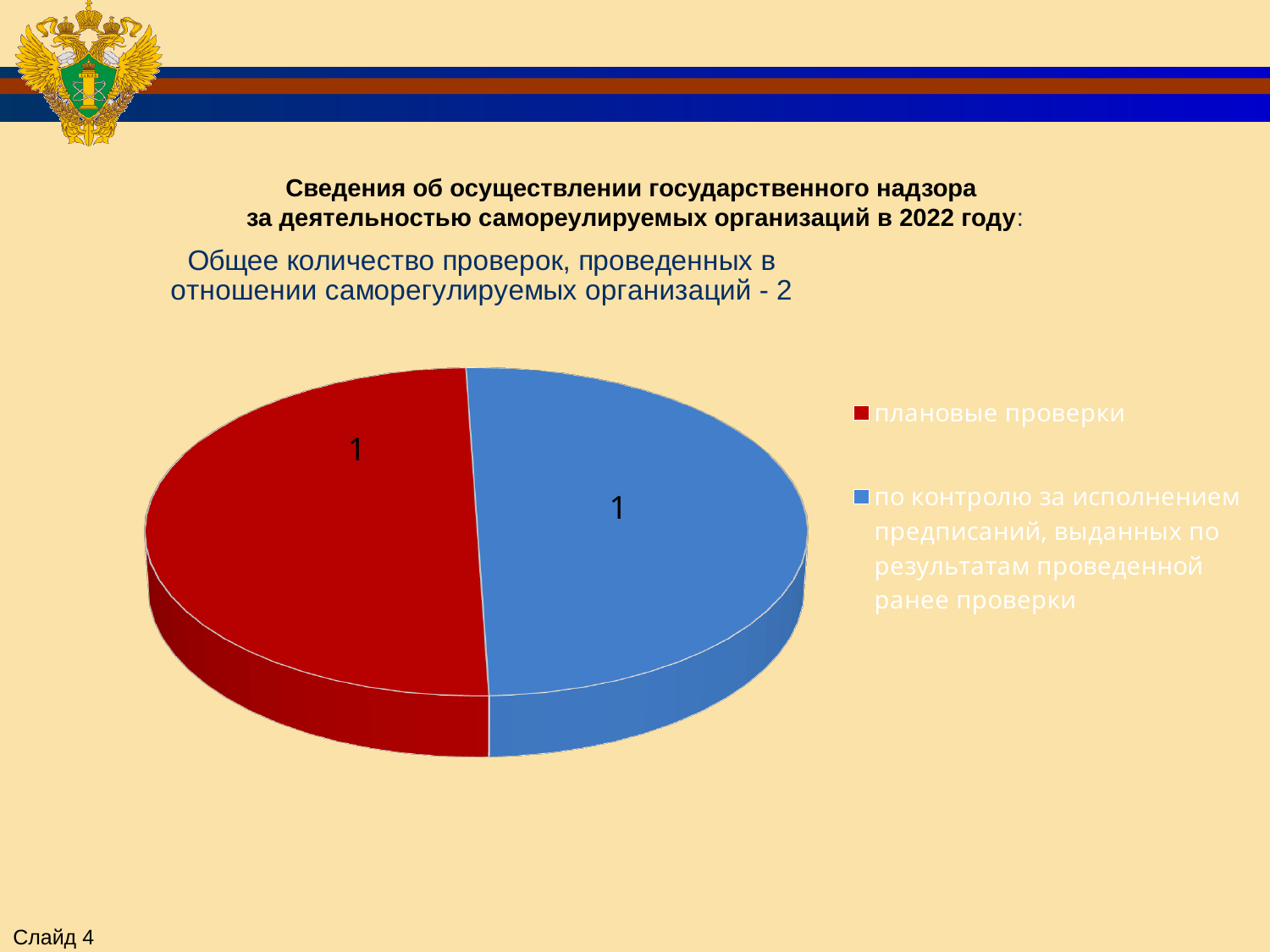
What value is shown for the "плановые проверки" slice? 1 How many entries does the legend list? 2 What colour is the "плановые проверки" slice? Red What kind of chart is shown on the slide? Pie chart What share of the pie does the "плановые проверки" slice represent? 50% What colour is the slice for "по контролю за исполнением предписаний, выданных по результатам проведенной ранее проверки"? Blue How many slices does the pie chart have? 2 What is the total of all slices in the pie chart? 2 What share of the pie does the slice "по контролю за исполнением предписаний, выданных по результатам проведенной ранее проверки" represent? 50% What value is shown for the slice "по контролю за исполнением предписаний, выданных по результатам проведенной ранее проверки"? 1